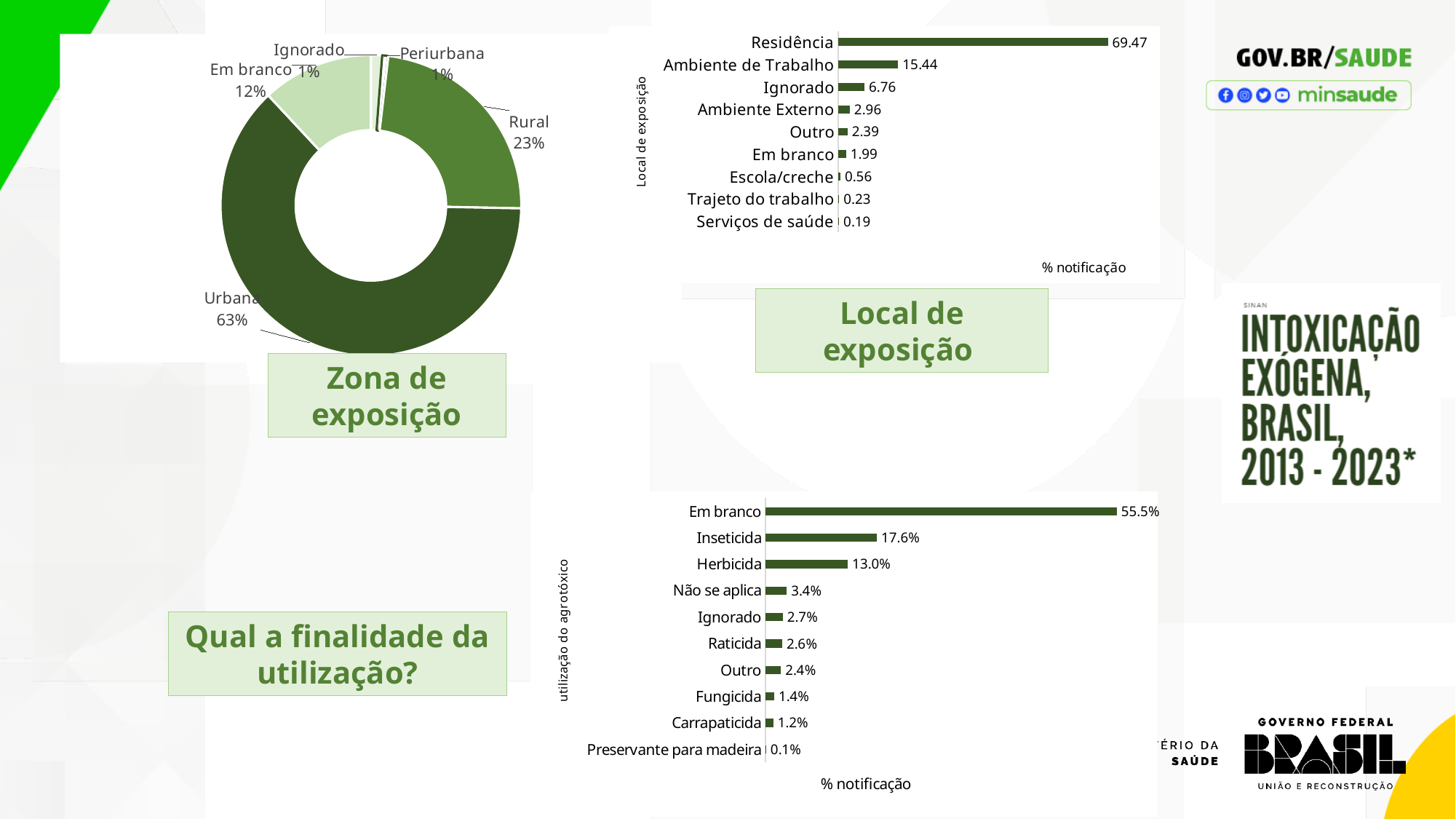
In the 'Qual a finalidade da utilização?' chart, how many categories are shown? 10 What kind of chart is the 'Zona de exposição' chart? Doughnut (pie) chart In the 'Local de exposição' chart, what is the value for Residência? 69.47 In the 'Zona de exposição' chart, what share of notifications is Urbana? 63% In the 'Qual a finalidade da utilização?' chart, which is larger: Herbicida or Raticida? Herbicida In the 'Qual a finalidade da utilização?' chart, which category has the highest value? Em branco In the 'Qual a finalidade da utilização?' chart, what is the value for Inseticida? 17.6% In the 'Local de exposição' chart, how many categories are shown? 9 In the 'Local de exposição' chart, what is the difference between Residência and Ambiente de Trabalho? 54.03 In the 'Zona de exposição' chart, what share of notifications is Rural? 23% In the 'Local de exposição' chart, which category has the lowest value? Serviços de saúde In the 'Local de exposição' chart, what is the value for Ambiente de Trabalho? 15.44